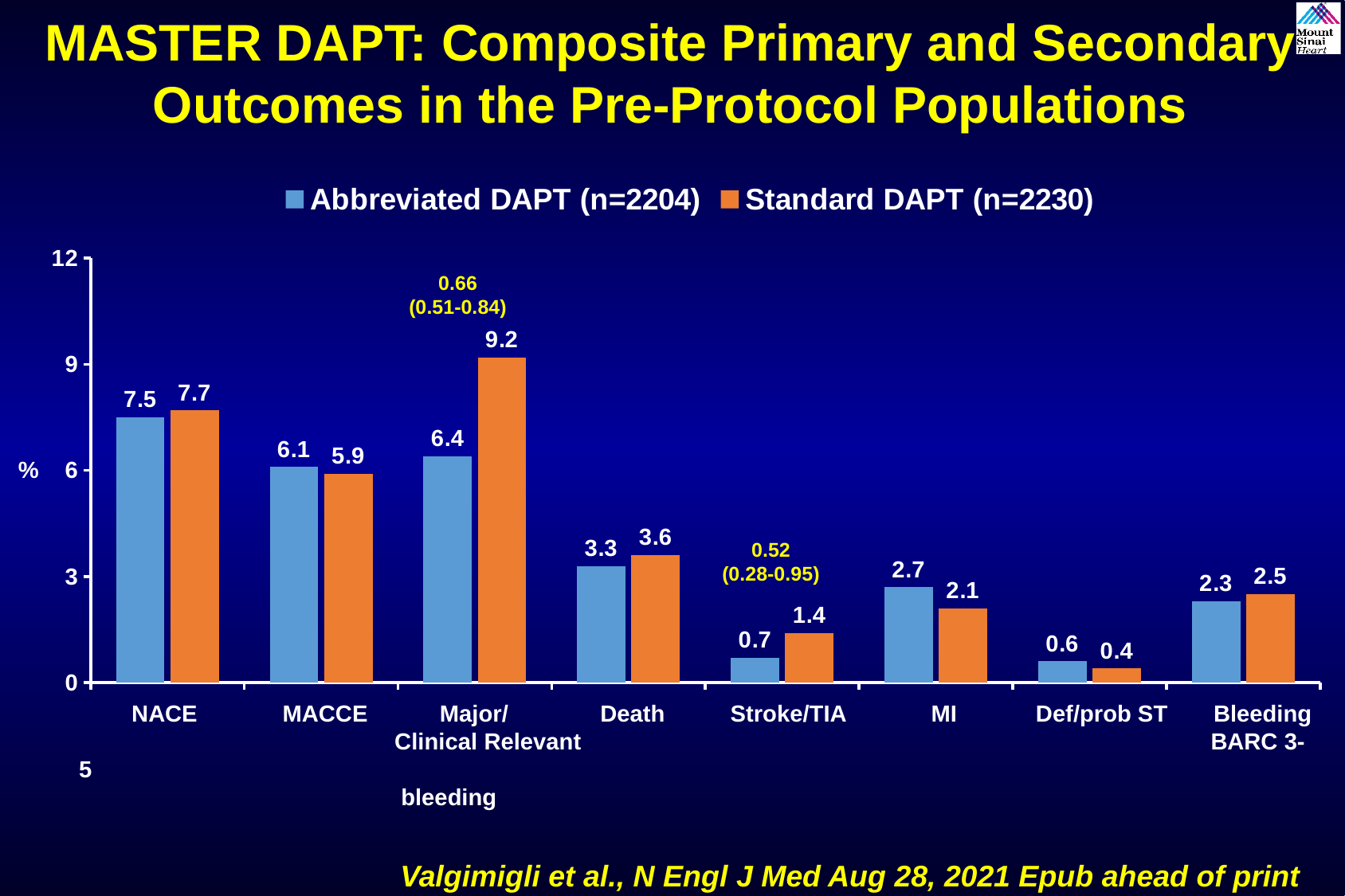
Which category has the highest value for Standard DAPT (n=2230)? Major/Clinical Relevant bleeding What is the value for Standard DAPT (n=2230) in the Stroke/TIA category? 1.4 Which category has the lowest value for Abbreviated DAPT (n=2204)? Def/prob ST How many outcome categories are shown on the x axis? 8 Is the value for Standard DAPT (n=2230) in the Death category greater or less than 3? greater What is the difference between the Standard DAPT and Abbreviated DAPT values in the Major/Clinical Relevant bleeding category? 2.8 What kind of chart is shown on the slide? Bar chart What is the value for Abbreviated DAPT (n=2204) in the NACE category? 7.5 What is the unit shown on the y axis label? % How many series does the legend list? 2 What is the value for Standard DAPT (n=2230) in the Major/Clinical Relevant bleeding category? 9.2 Which is larger in the MI category: Abbreviated DAPT (n=2204) or Standard DAPT (n=2230)? Abbreviated DAPT (n=2204)